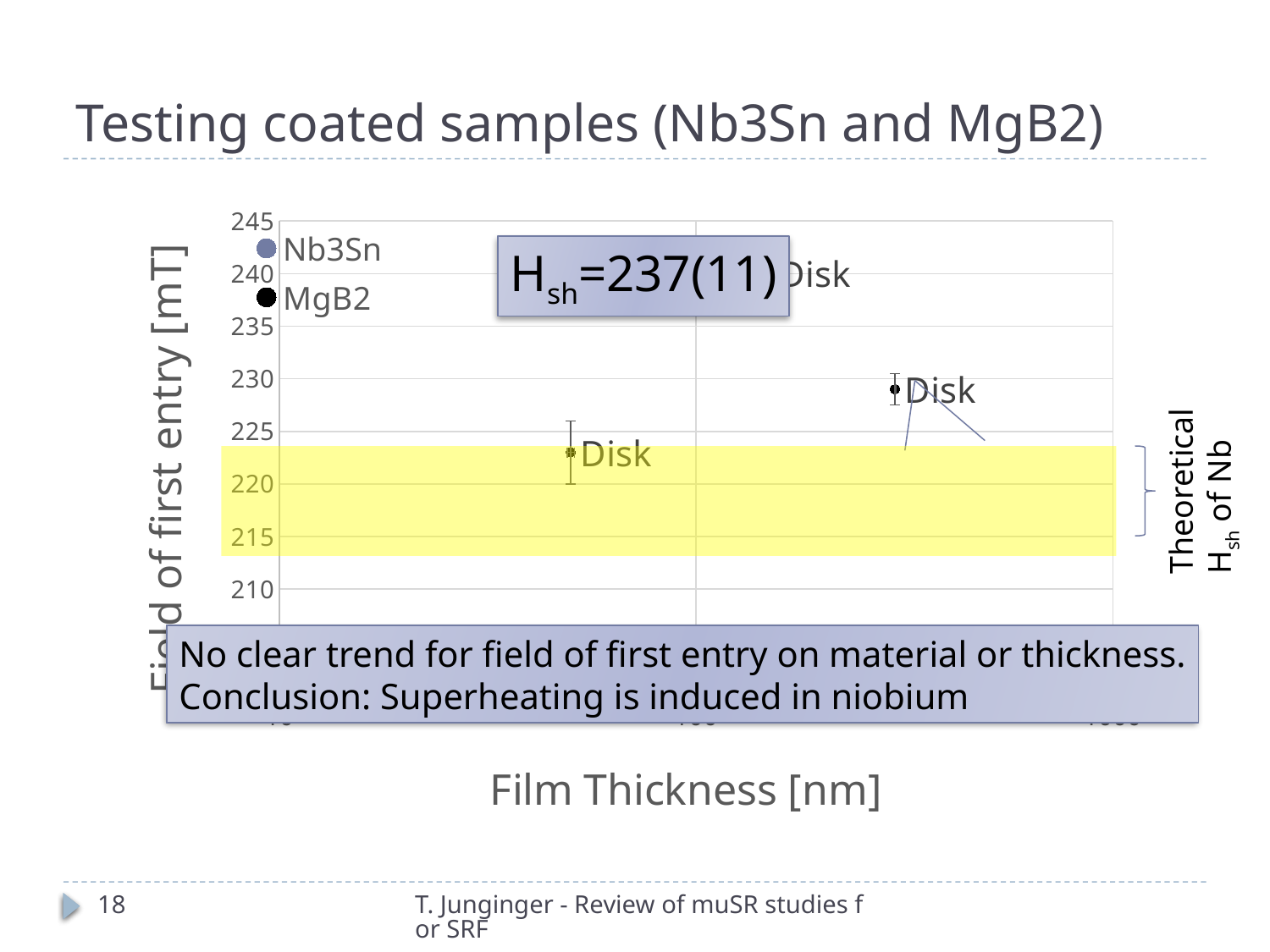
Is the value of the lowest "Disk" point (the one near the yellow band) greater or less than 225? less How many data points labelled "Disk" are plotted on the chart? 3 According to the slide, is there a clear trend of field of first entry with film thickness? No What are the two series named in the chart legend? Nb3Sn and MgB2 Is the value of the lowest "Disk" point (the one near the yellow band) greater or less than 220? greater Which is higher: the black MgB2 "Disk" point or the "Disk" point lying just above the yellow band? the black MgB2 Disk point Is the value of the black MgB2 "Disk" point greater or less than 225? greater How many series does the chart legend list? 2 What kind of chart is shown on the slide? scatter chart What value of H_sh is given in the box at the top of the chart? Hsh=237(11)